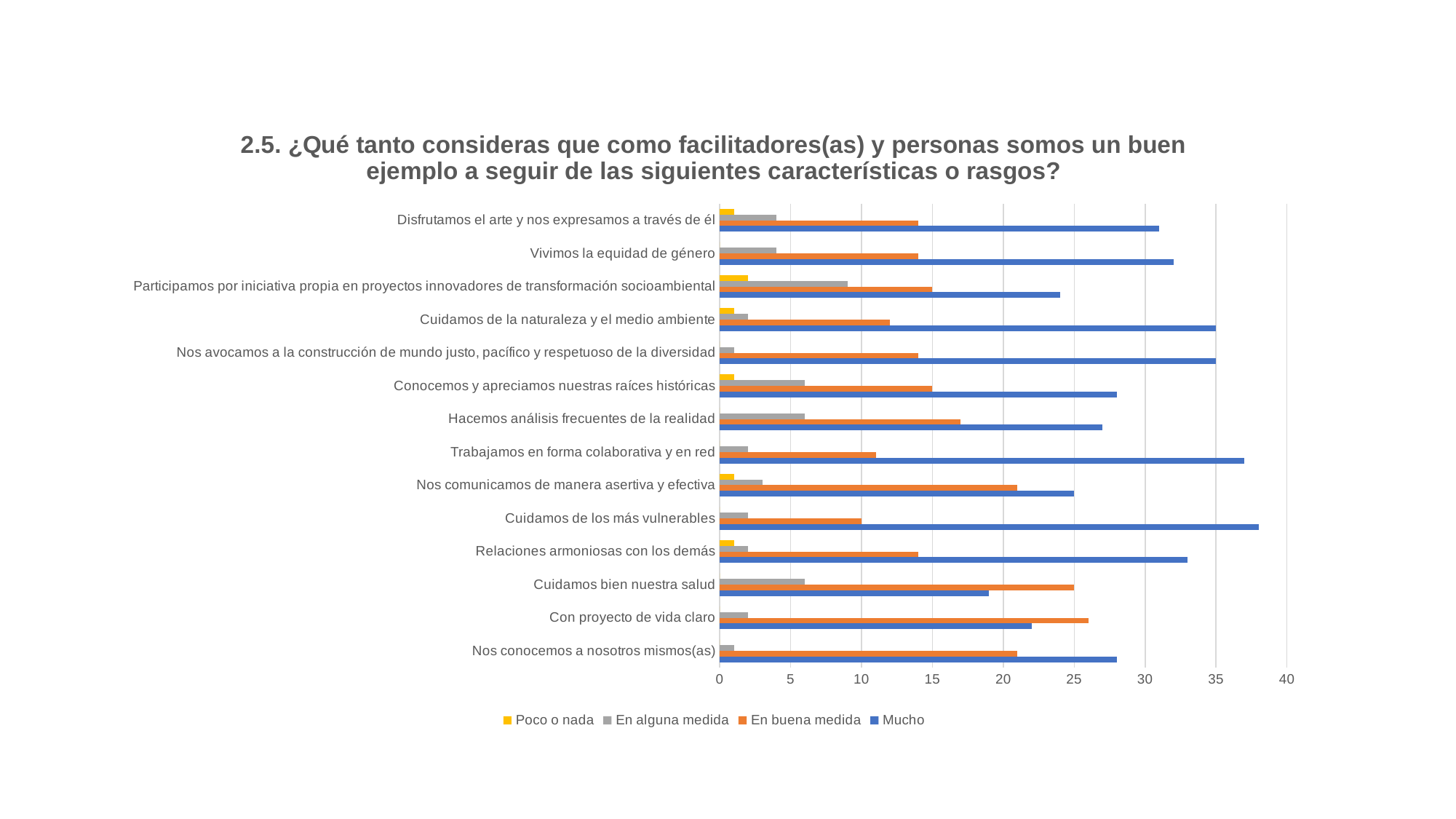
What is the 'Mucho' value for 'Cuidamos de la naturaleza y el medio ambiente'? 35 Is the 'Mucho' value for 'Cuidamos bien nuestra salud' greater or less than 25? less Is the 'Mucho' value for 'Disfrutamos el arte y nos expresamos a través de él' greater or less than 25? greater For 'Cuidamos bien nuestra salud', which is larger: 'En buena medida' or 'Mucho'? En buena medida Which category has the lowest value for the 'Mucho' series? Cuidamos bien nuestra salud How many series does the legend list? 4 Is the 'Mucho' value for 'Cuidamos de los más vulnerables' greater or less than 35? greater For 'Nos comunicamos de manera asertiva y efectiva', which is larger: 'En buena medida' or 'Mucho'? Mucho What kind of chart is shown on the slide? bar chart How many categories (characteristics) are plotted on the chart? 14 Which series is shown in blue in the legend? Mucho